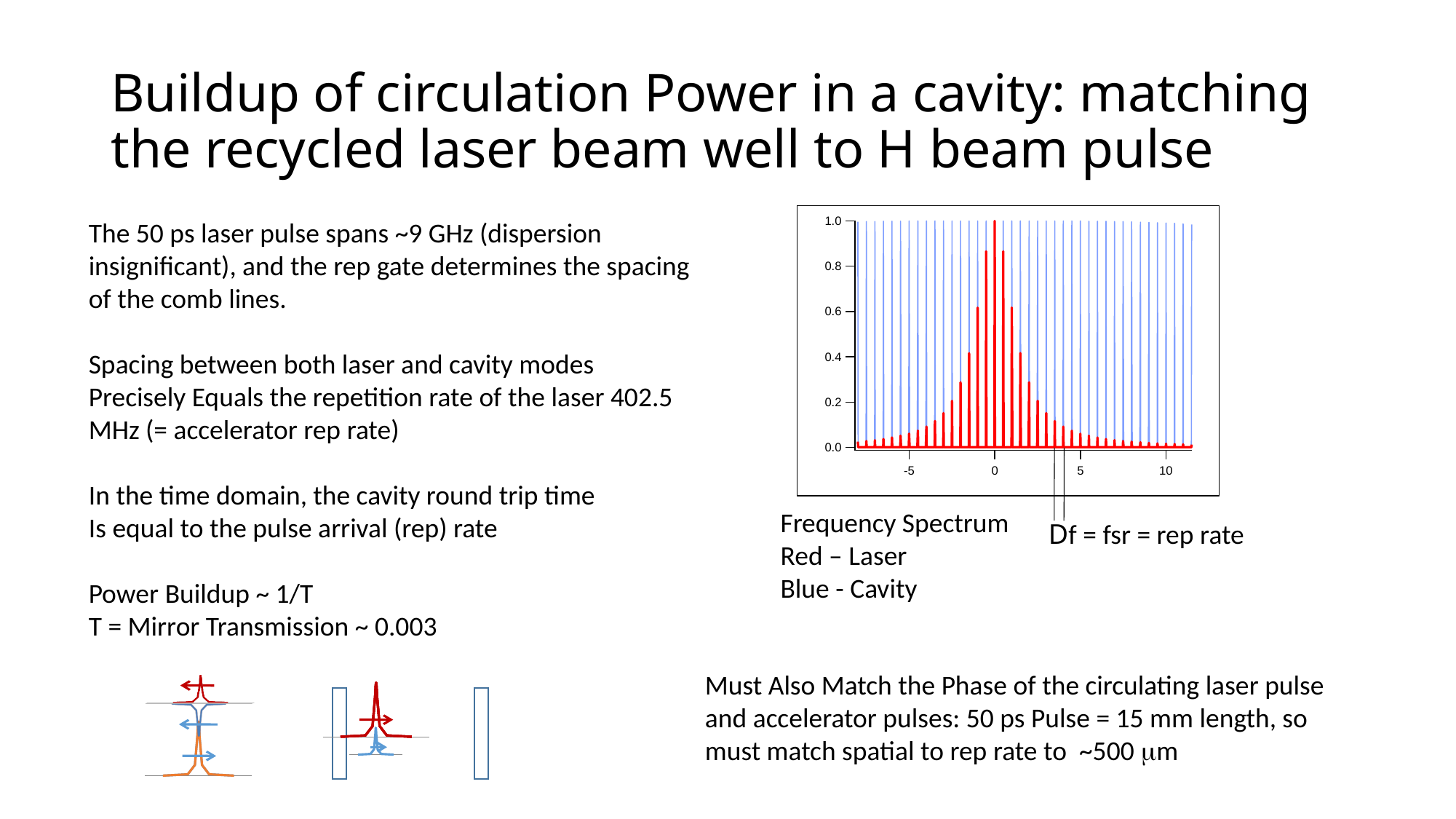
What is the title given for the chart on the slide? Frequency Spectrum In the Frequency Spectrum chart, is the red (laser) value at x = 10 greater or less than 0.2? less In the Frequency Spectrum chart, which is larger at x = 5: the red (laser) line or the blue (cavity) line? blue (cavity) In the Frequency Spectrum chart, what is the peak value of the red (laser) spectrum at x = 0? 1.0 In the Frequency Spectrum chart, what is the maximum value shown on the y axis? 1.0 In the Frequency Spectrum chart, which series is drawn in red? Laser In the Frequency Spectrum chart, at which x-axis value does the red (laser) spectrum reach its peak? 0 In the Frequency Spectrum chart, is the red (laser) value at x = 5 greater or less than 0.2? less How many series does the chart's legend text list? 2 In the Frequency Spectrum chart, is the red (laser) value at x = -5 greater or less than 0.2? less In the Frequency Spectrum chart, do the red (laser) line heights rise or fall as x goes from 0 to 10? fall